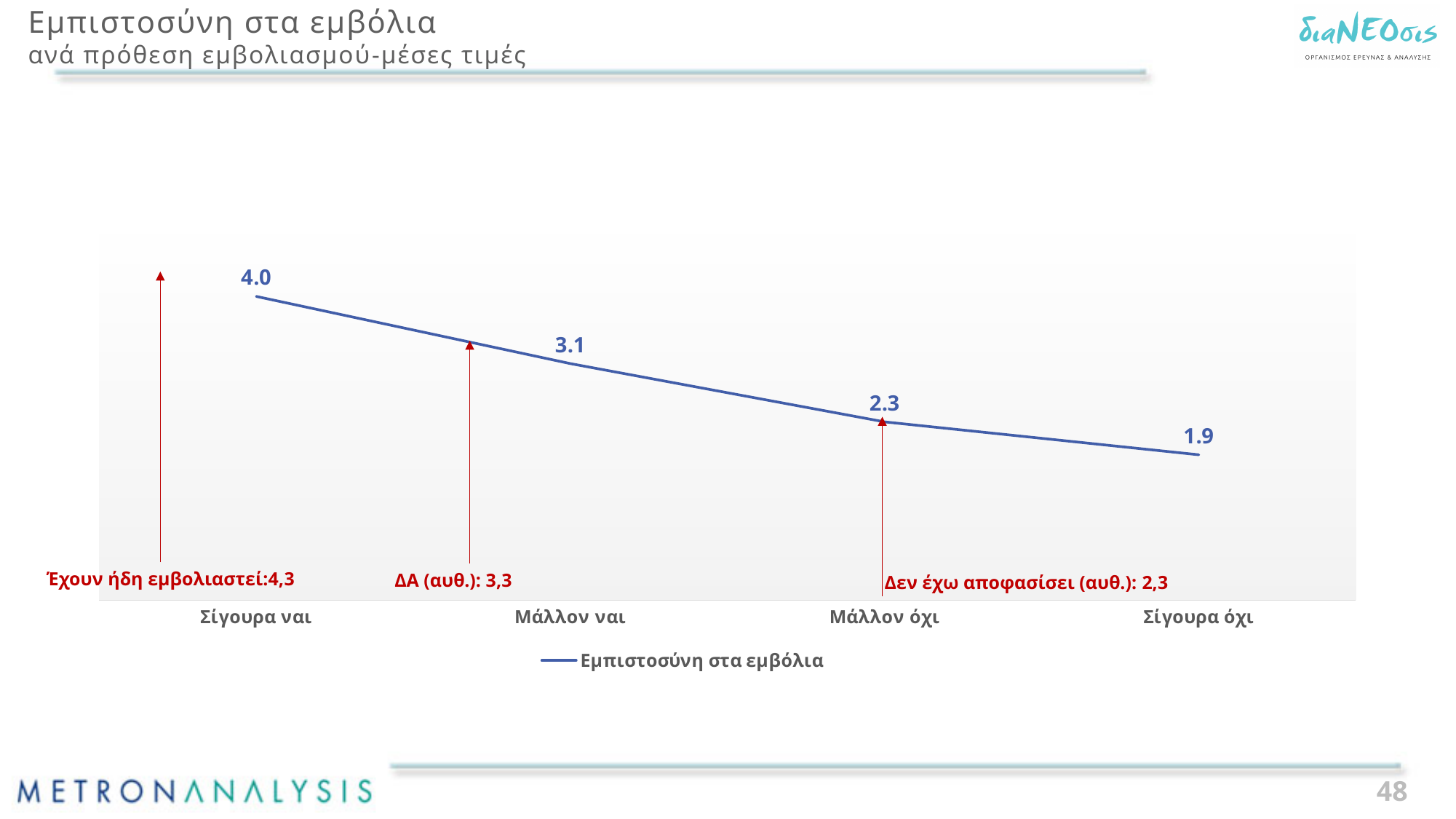
What is the difference between the values for Σίγουρα ναι and Σίγουρα όχι? 2.1 Which category has the highest value? Σίγουρα ναι What is the value for Σίγουρα ναι? 4.0 What is the value for Μάλλον όχι? 2.3 What is the value for Σίγουρα όχι? 1.9 What kind of chart is shown on the slide? Line chart What series name does the legend show? Εμπιστοσύνη στα εμβόλια What is the value for Μάλλον ναι? 3.1 Which category has the lowest value? Σίγουρα όχι Which is larger, the value for Μάλλον ναι or the value for Μάλλον όχι? Μάλλον ναι Do the values rise or fall from Σίγουρα ναι to Σίγουρα όχι? Fall How many categories are plotted on the x axis? 4